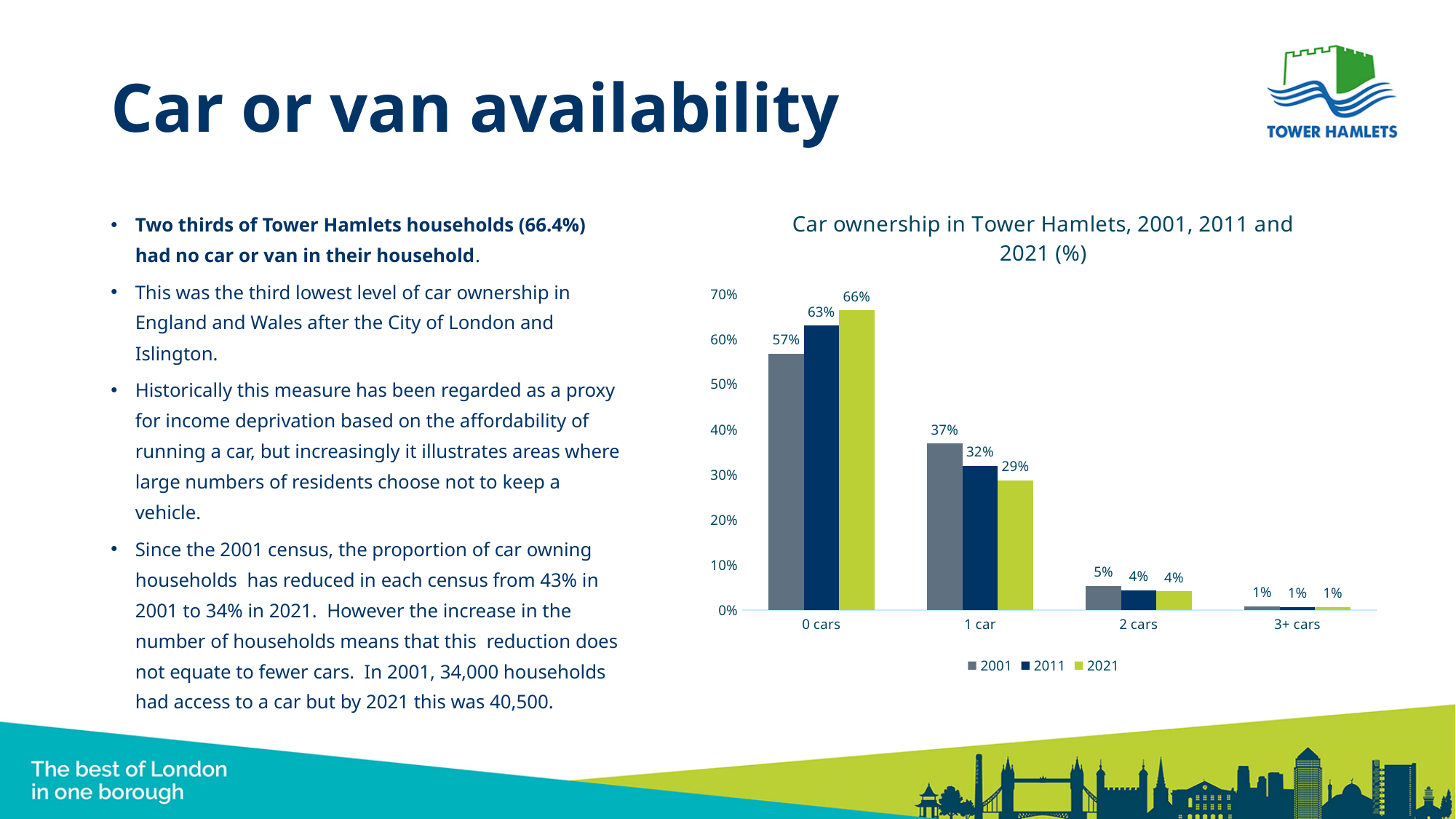
How many series does the legend list? 3 What is the difference between the 2021 and 2001 values for 0 cars? 9% How many categories are shown on the x axis? 4 Which is larger for 1 car: the 2001 value or the 2021 value? 2001 What percentage of households had 0 cars in 2021? 66% Does the 0 cars value rise or fall from 2001 to 2021? Rise What percentage of households had 2 cars in 2011? 4% What is the title of the chart? Car ownership in Tower Hamlets, 2001, 2011 and 2021 (%) Which category has the lowest value for 2001? 3+ cars Which category has the highest value for 2011? 0 cars What kind of chart is shown on the slide? Bar chart What percentage of households had 1 car in 2001? 37%